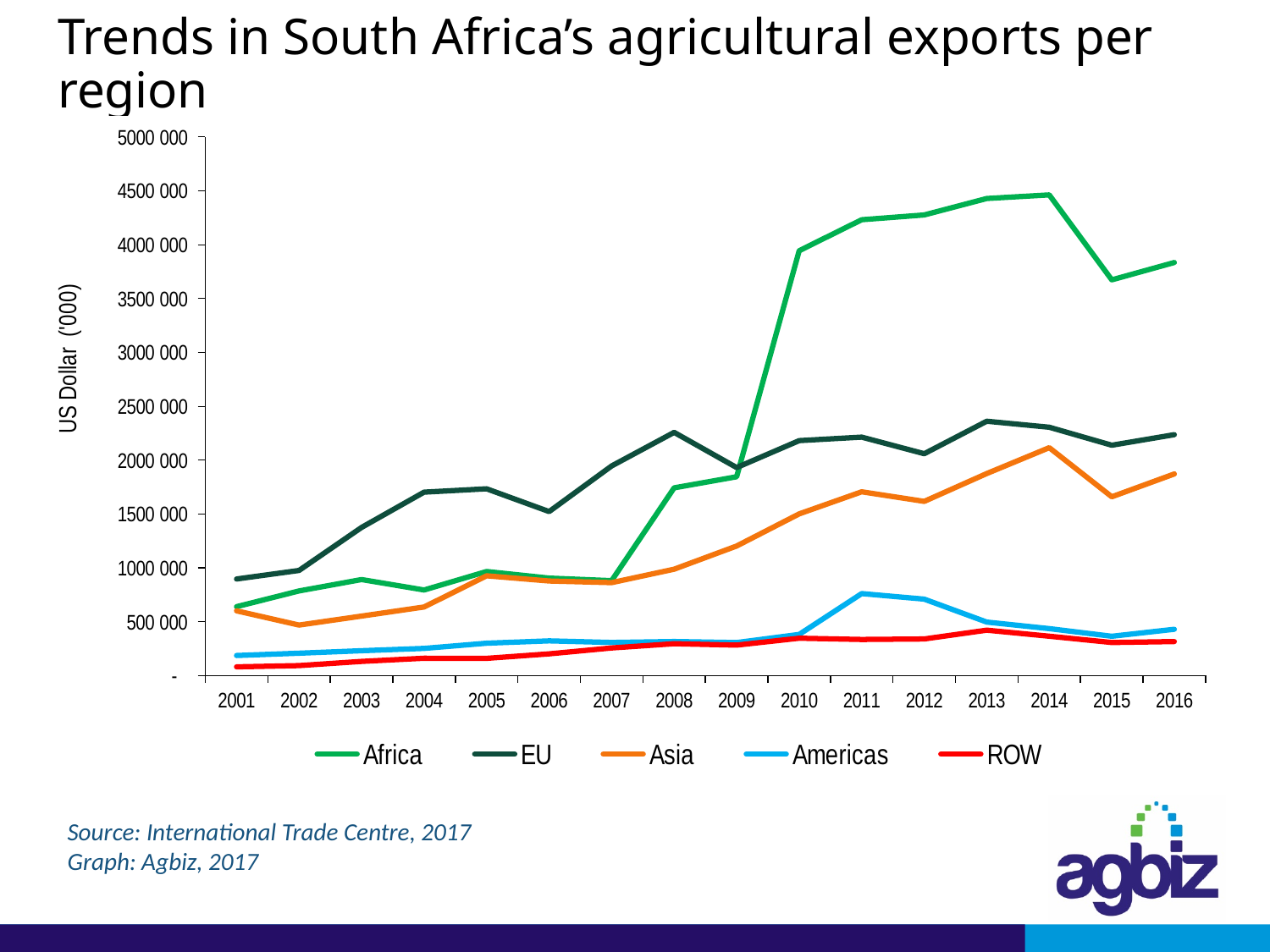
Is the value for Africa in 2014 greater or less than 4000 000? greater Which is larger in 2010, the value for Africa or the value for EU? Africa Is the value for EU in 2001 greater or less than 1000 000? less Which is larger in 2005, the value for EU or the value for Asia? EU Which region has the lowest export value in 2016? ROW How many series does the legend list? 5 How many years are plotted along the x axis? 16 Is the value for Americas in 2011 greater or less than 500 000? greater Which region has the highest export value in 2016? Africa What kind of chart is shown on the slide? line chart In which year does the Americas series reach its peak? 2011